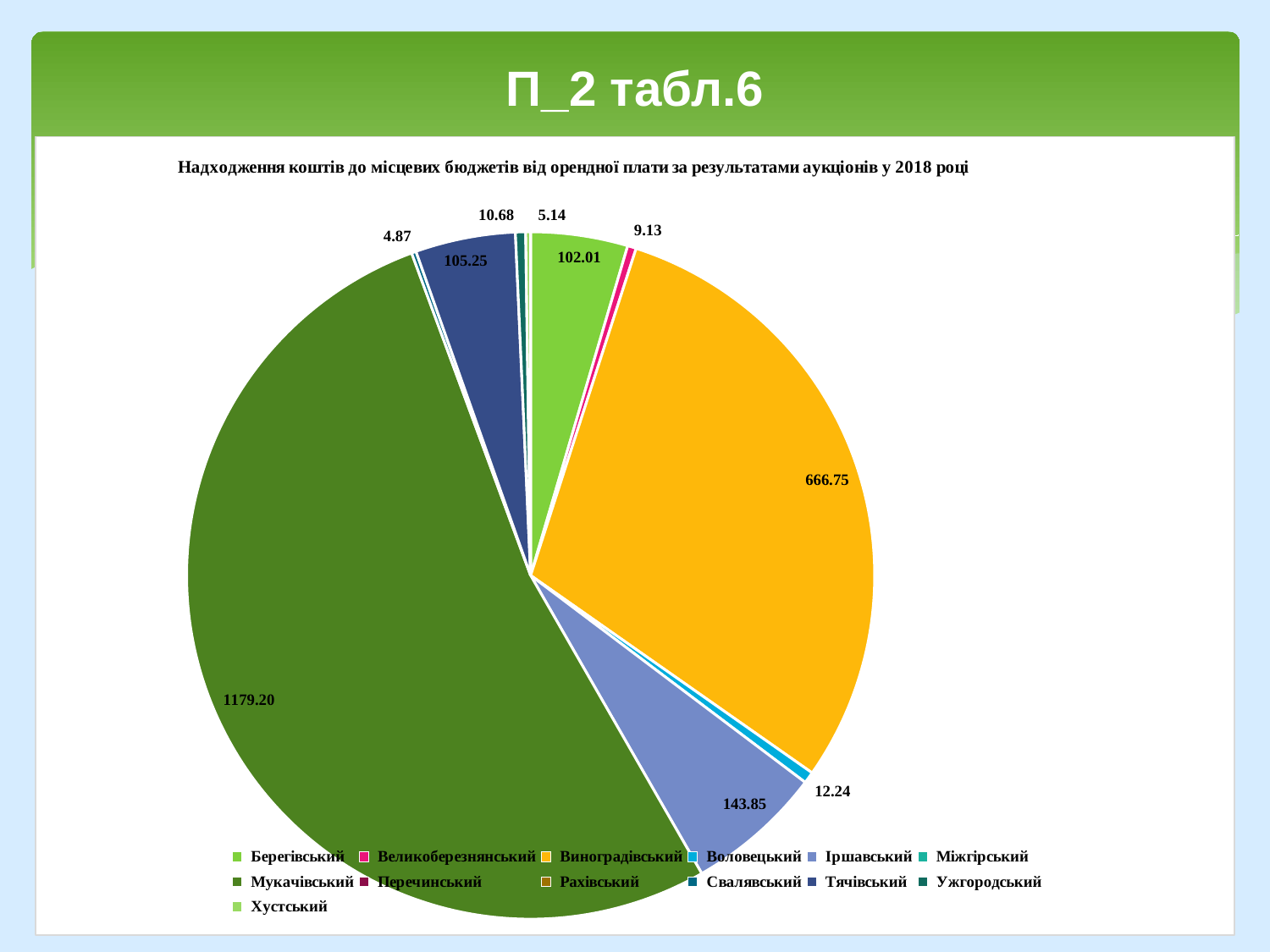
What is the value for Виноградівський? 666.75 What is the title of the chart? Надходження коштів до місцевих бюджетів від орендної плати за результатами аукціонів у 2018 році What is the value for Тячівський? 105.25 Which is larger, the value for Іршавський or the value for Тячівський? Іршавський Which category has the largest slice of the pie? Мукачівський What kind of chart is shown on the slide? pie chart How many categories does the legend list? 13 What is the value for Іршавський? 143.85 What is the value for Мукачівський? 1179.20 What is the value for Берегівський? 102.01 What is the value for Воловецький? 12.24 What is the difference between the values for Мукачівський and Виноградівський? 512.45